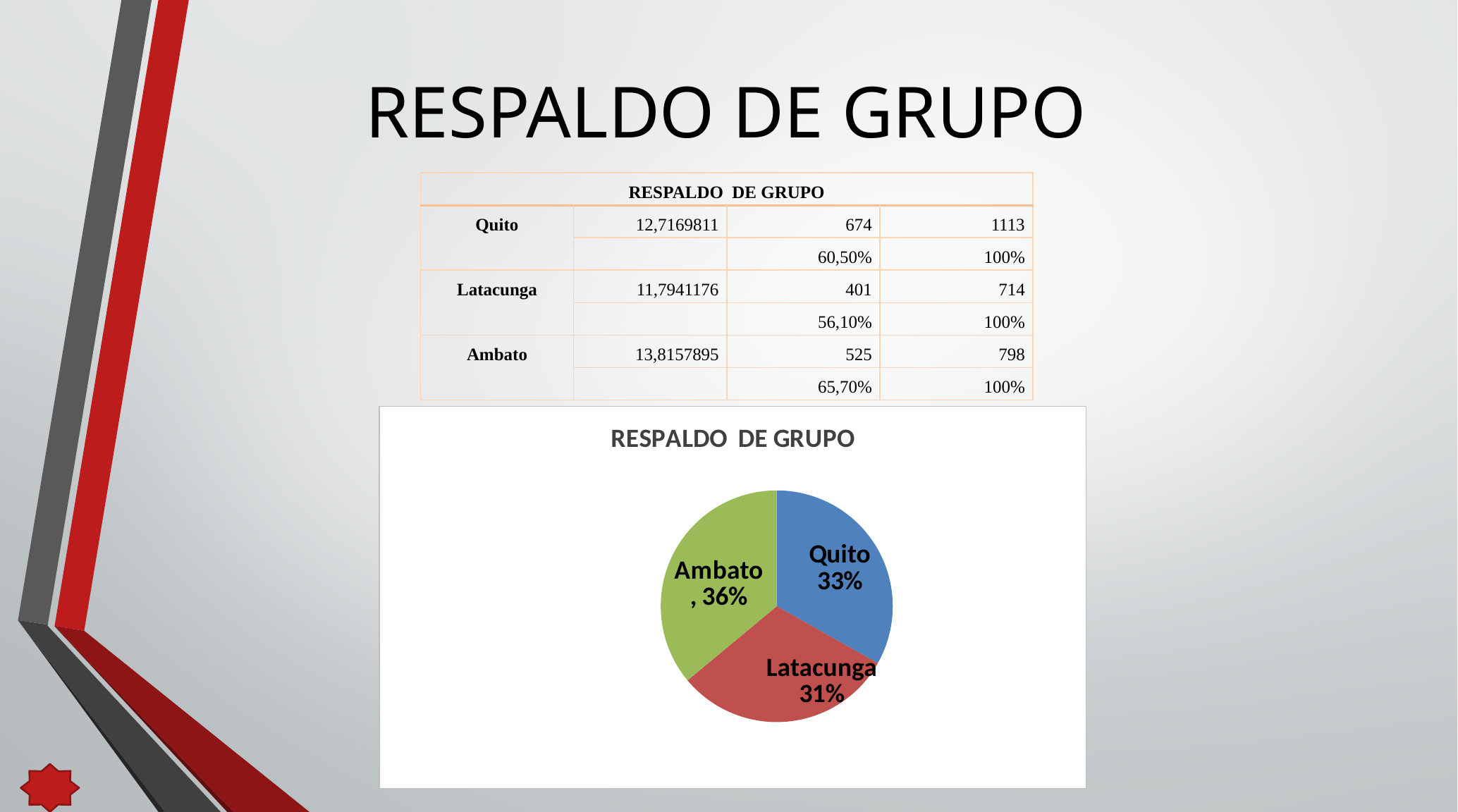
What is the difference in percentage points between the Ambato and Latacunga slices? 5 Which slice of the pie chart is the smallest? Latacunga How many slices does the pie chart have? 3 What is the difference in percentage points between the Ambato and Quito slices? 3 What colour is the Ambato slice in the pie chart? green What share of the pie does Latacunga represent? 31% What share of the pie does Quito represent? 33% What kind of chart is shown on the slide? pie chart What is the title of the chart? RESPALDO DE GRUPO What share of the pie does Ambato represent? 36% Which slice of the pie chart is the largest? Ambato Which slice is larger, Quito or Latacunga? Quito